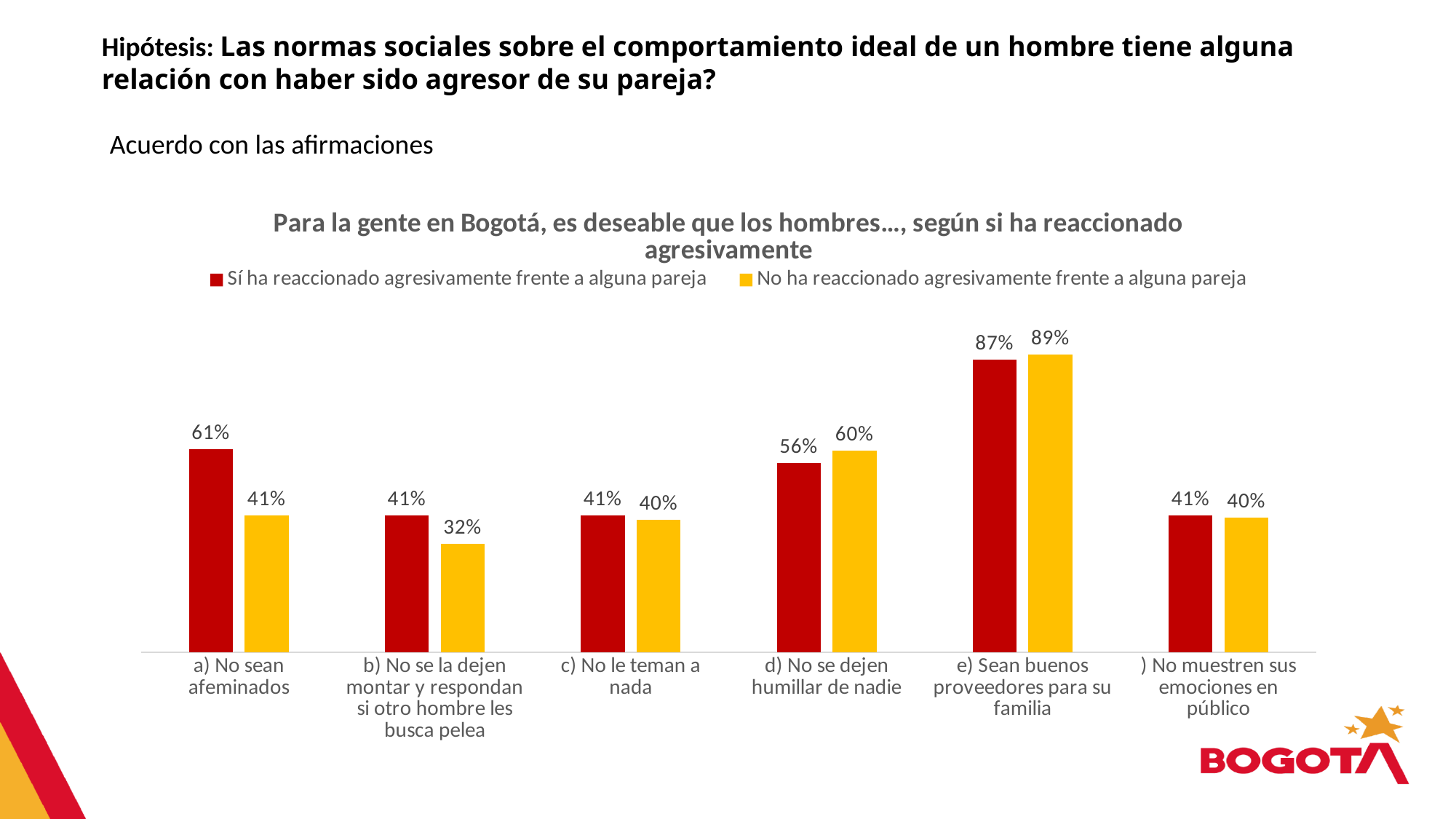
What value is shown for 'No ha reaccionado agresivamente frente a alguna pareja' in the category 'b) No se la dejen montar y respondan si otro hombre les busca pelea'? 32% What value is shown for 'No ha reaccionado agresivamente frente a alguna pareja' in the category 'e) Sean buenos proveedores para su familia'? 89% What kind of chart is shown on the slide? Bar chart How many series does the legend list? 2 What value is shown for 'Sí ha reaccionado agresivamente frente a alguna pareja' in the category 'a) No sean afeminados'? 61% What value is shown for 'Sí ha reaccionado agresivamente frente a alguna pareja' in the category 'd) No se dejen humillar de nadie'? 56% Which category has the lowest value for 'No ha reaccionado agresivamente frente a alguna pareja'? b) No se la dejen montar y respondan si otro hombre les busca pelea Which colour represents the series 'Sí ha reaccionado agresivamente frente a alguna pareja'? Red What is the difference between the two series in the category 'a) No sean afeminados'? 20 percentage points How many categories are shown on the x axis of the chart? 6 In the category 'd) No se dejen humillar de nadie', which series has the larger value? No ha reaccionado agresivamente frente a alguna pareja Which category has the highest value for 'Sí ha reaccionado agresivamente frente a alguna pareja'? e) Sean buenos proveedores para su familia